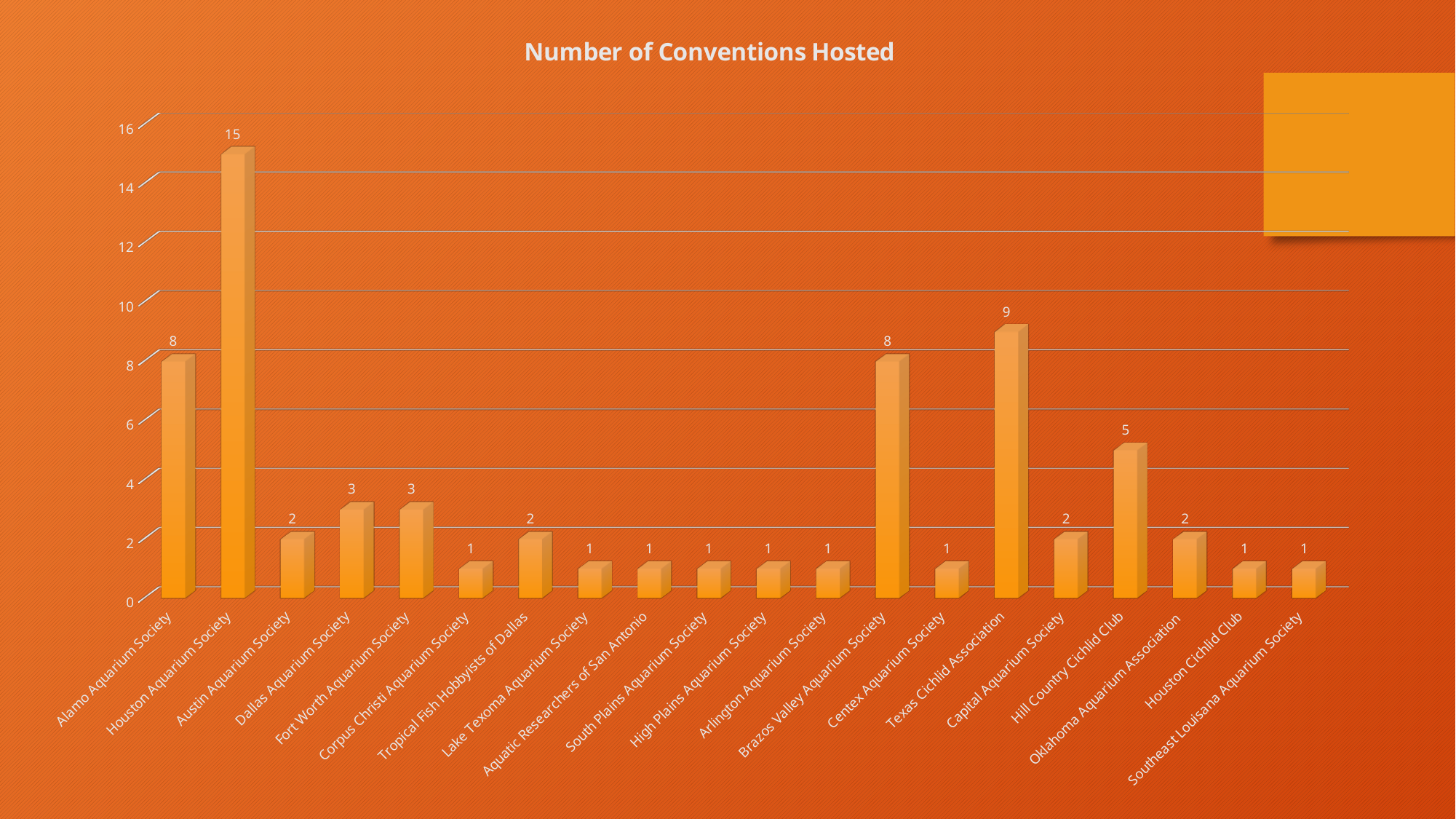
What is the title of the chart? Number of Conventions Hosted How many conventions has the Houston Aquarium Society hosted? 15 What is the difference between the values for the Alamo Aquarium Society and the Dallas Aquarium Society? 5 What is the difference between the values for the Houston Aquarium Society and the Texas Cichlid Association? 6 What is the value for the Hill Country Cichlid Club? 5 What is the value for the Texas Cichlid Association? 9 How many organizations are shown on the x axis? 20 Which organization hosted the most conventions? Houston Aquarium Society Which is larger, the value for the Brazos Valley Aquarium Society or the Hill Country Cichlid Club? Brazos Valley Aquarium Society Is the value for the Texas Cichlid Association greater or less than 10? less What is the value for the Oklahoma Aquarium Association? 2 What type of chart is shown on the slide? bar chart